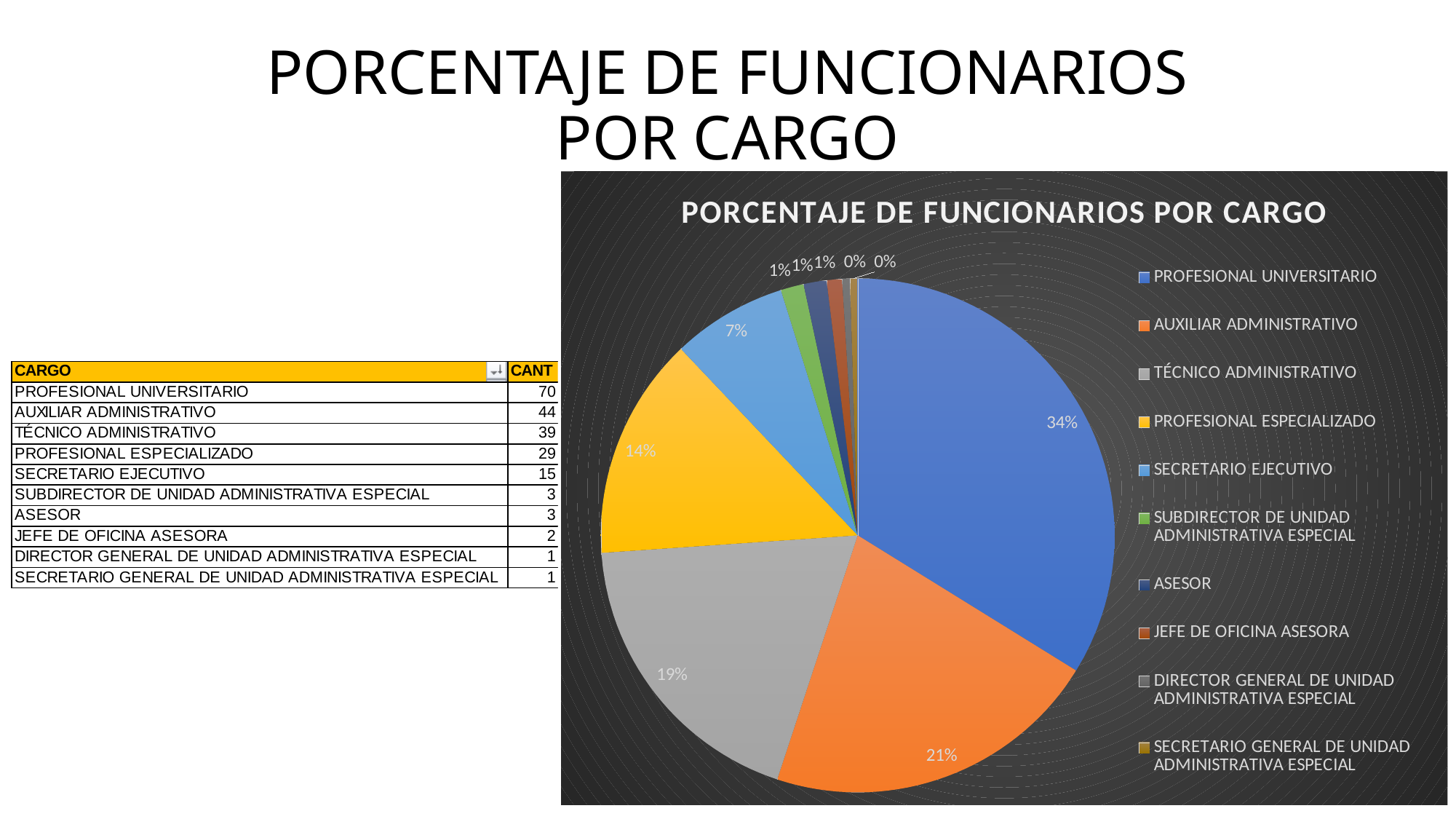
Which category has the largest slice of the pie? PROFESIONAL UNIVERSITARIO What percentage of the pie does PROFESIONAL ESPECIALIZADO represent? 14% What percentage of the pie does TÉCNICO ADMINISTRATIVO represent? 19% How many categories does the legend of the pie chart list? 10 What kind of chart is shown on the slide? pie chart Which slice is larger, AUXILIAR ADMINISTRATIVO or PROFESIONAL ESPECIALIZADO? AUXILIAR ADMINISTRATIVO What colour is the slice for PROFESIONAL ESPECIALIZADO? yellow What percentage of the pie does SECRETARIO EJECUTIVO represent? 7% What is the difference in percentage points between the PROFESIONAL UNIVERSITARIO slice and the SECRETARIO EJECUTIVO slice? 27 What is the title of the chart? PORCENTAJE DE FUNCIONARIOS POR CARGO